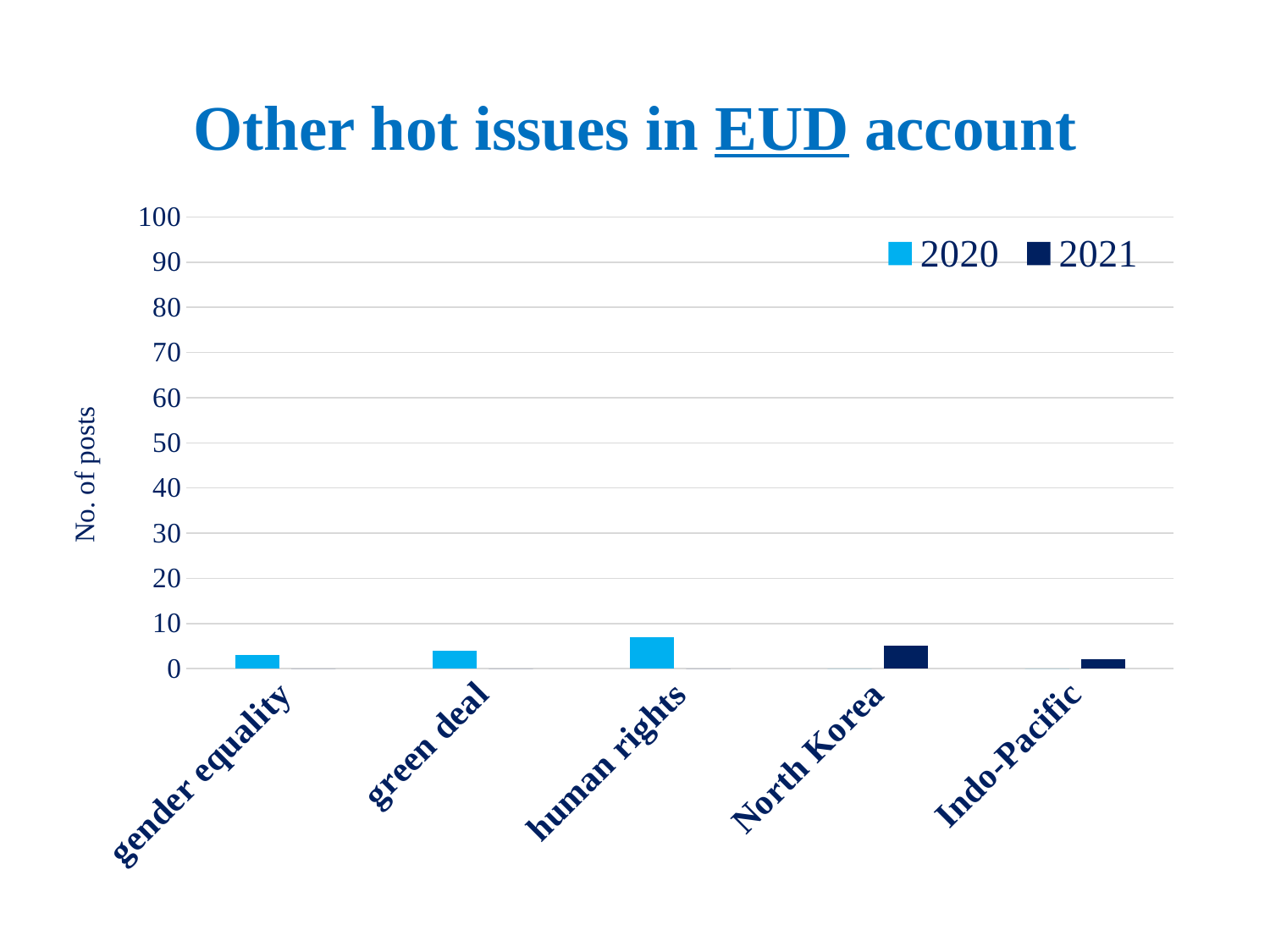
What kind of chart is shown on the slide? bar chart Which is larger: the 2020 value for human rights or the 2020 value for gender equality? human rights Which category has the highest value for the 2021 series? North Korea Is the value for green deal in 2020 greater or less than 20? less How many series does the chart's legend list? 2 Which is larger: the 2021 value for North Korea or the 2021 value for Indo-Pacific? North Korea What is the label on the vertical axis of the chart? No. of posts How many categories are shown on the x axis of the chart? 5 Is the value for human rights in 2020 greater or less than 10? less Is the value for North Korea in 2021 greater or less than 10? less Which category has the highest value for the 2020 series? human rights What is the title of the chart on the slide? Other hot issues in EUD account